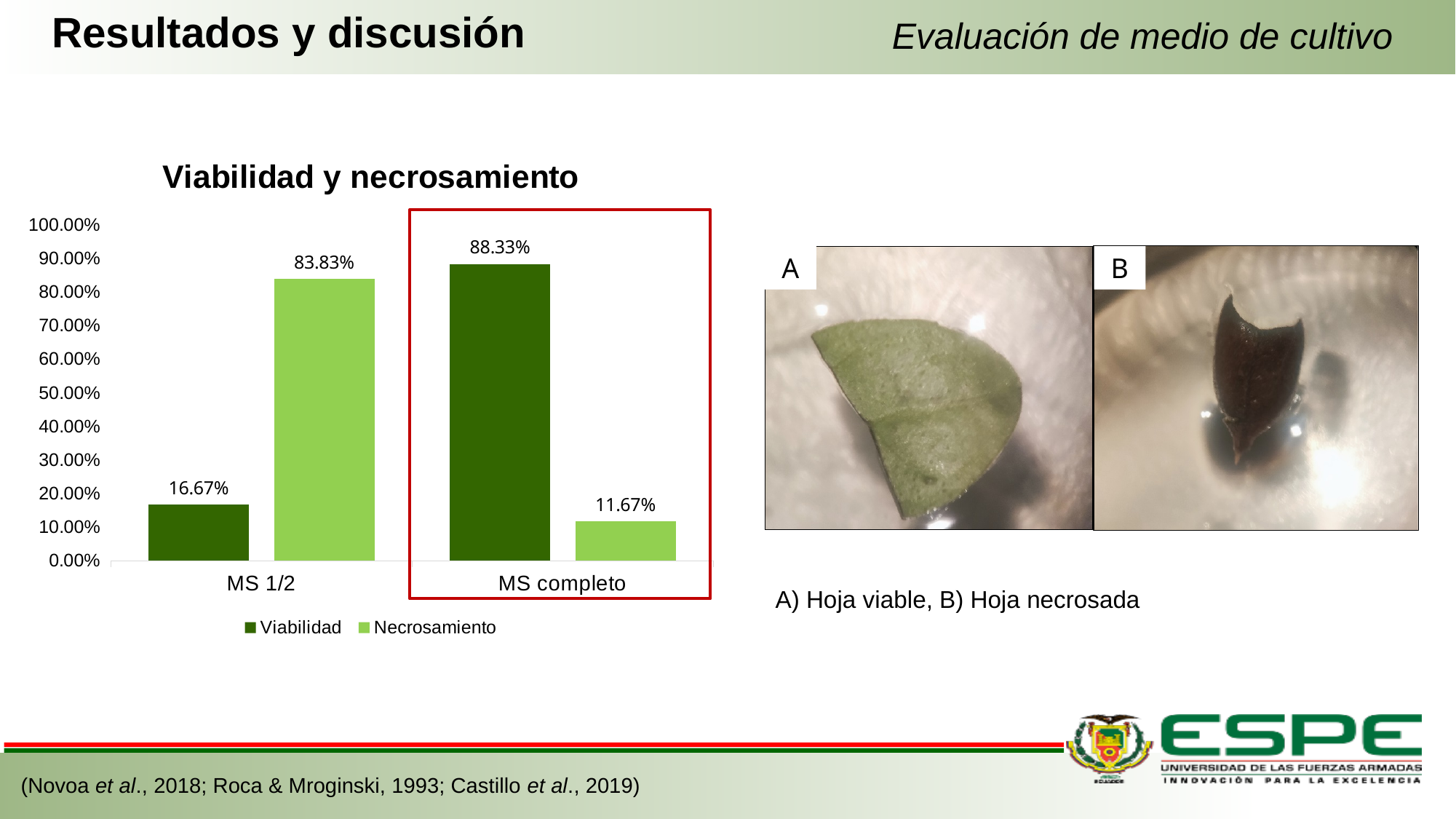
What kind of chart is shown? Bar chart What is the title of the chart? Viabilidad y necrosamiento What is the Necrosamiento value for MS 1/2? 83.83% What is the Viabilidad value for MS completo? 88.33% How many series does the legend list? 2 How many categories are shown on the x axis? 2 What is the Necrosamiento value for MS completo? 11.67% Which category has the lowest Necrosamiento value? MS completo Which is larger for MS 1/2: Viabilidad or Necrosamiento? Necrosamiento What is the Viabilidad value for MS 1/2? 16.67% What is the difference between the Viabilidad values for MS completo and MS 1/2? 71.66% Which category has the highest Viabilidad value? MS completo